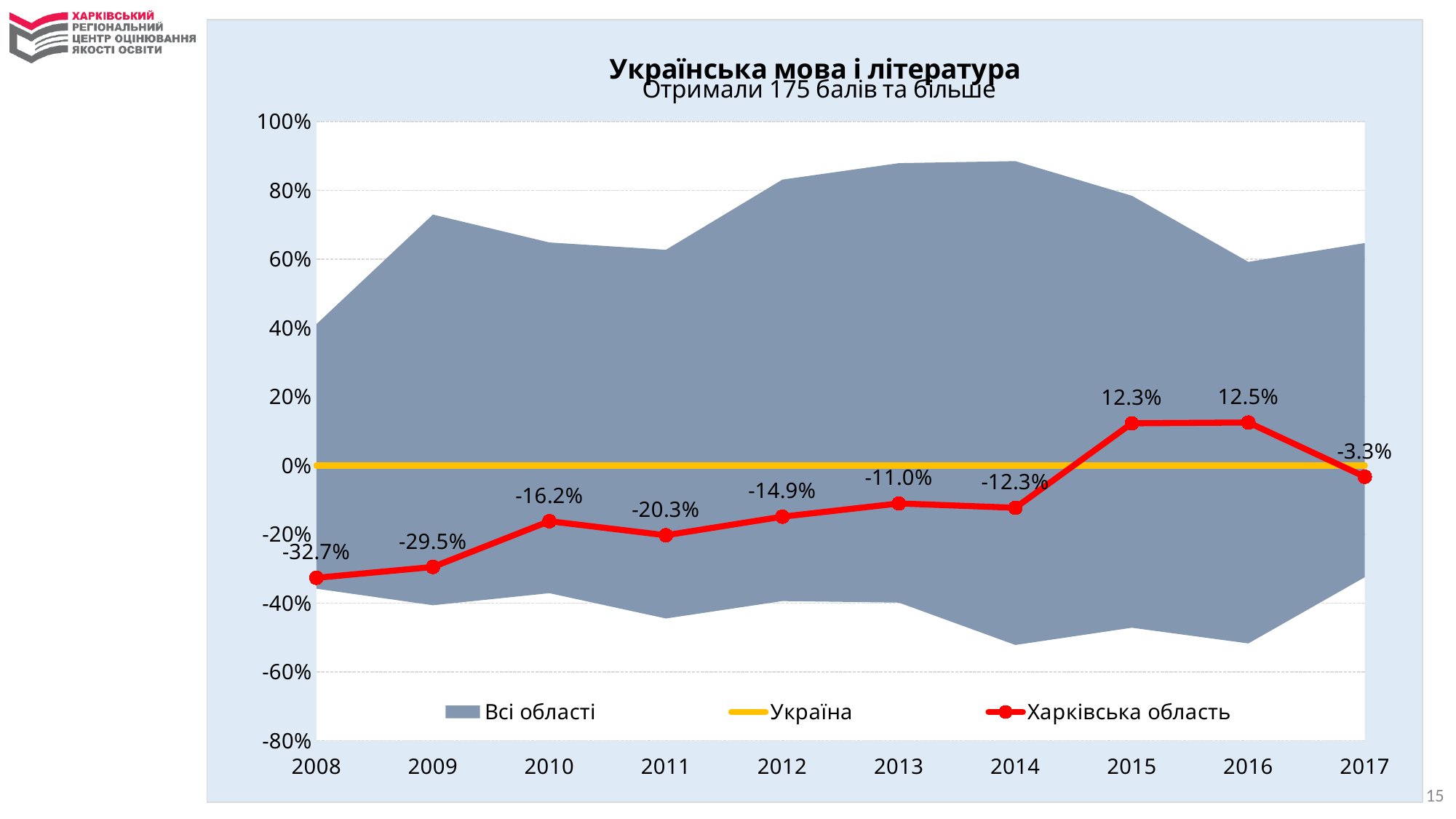
Which year has the larger value for Харківська область, 2010 or 2011? 2010 In which year is the value for Харківська область the lowest? 2008 What kind of chart is this? combination area and line chart How many years are shown on the x axis? 10 What is the difference between the Харківська область values for 2016 and 2017? 15.8 percentage points What is the value for Харківська область in 2017? -3.3% Is the upper edge of the Всі області band in 2014 greater or less than 80%? greater Does the value for Харківська область rise or fall from 2008 to 2010? rise In which year is the value for Харківська область the highest? 2016 What is the value for Харківська область in 2013? -11.0% What is the value for Харківська область in 2008? -32.7% How many series does the legend list? 3